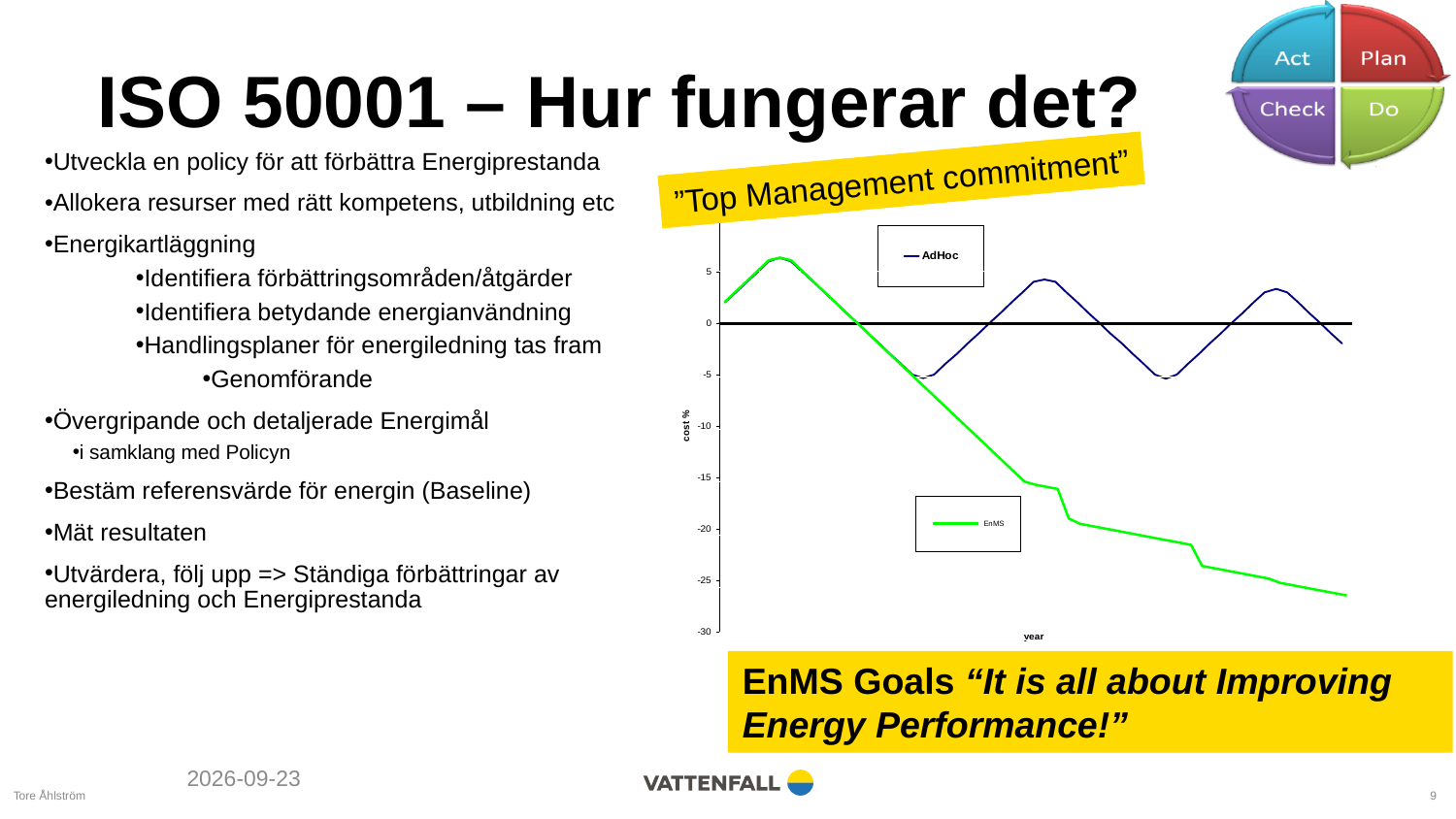
Is the lowest value of the EnMS line greater or less than -20? less Which series reaches the lowest value on the chart? EnMS Is the final value of the EnMS line greater or less than -10? less What kind of chart is shown on the slide? line chart At the right-hand end of the chart, which series has the higher value, AdHoc or EnMS? AdHoc Does the EnMS line rise or fall as it moves along the x axis? fall Is the highest value of the EnMS line greater or less than 0? greater Which series has the higher value at the right-hand end of the chart, and is that value greater or less than -10? AdHoc; greater What are the names of the two series in the chart's legend? AdHoc and EnMS How many series does the chart's legend list? 2 What is the title of the chart's vertical axis? cost %